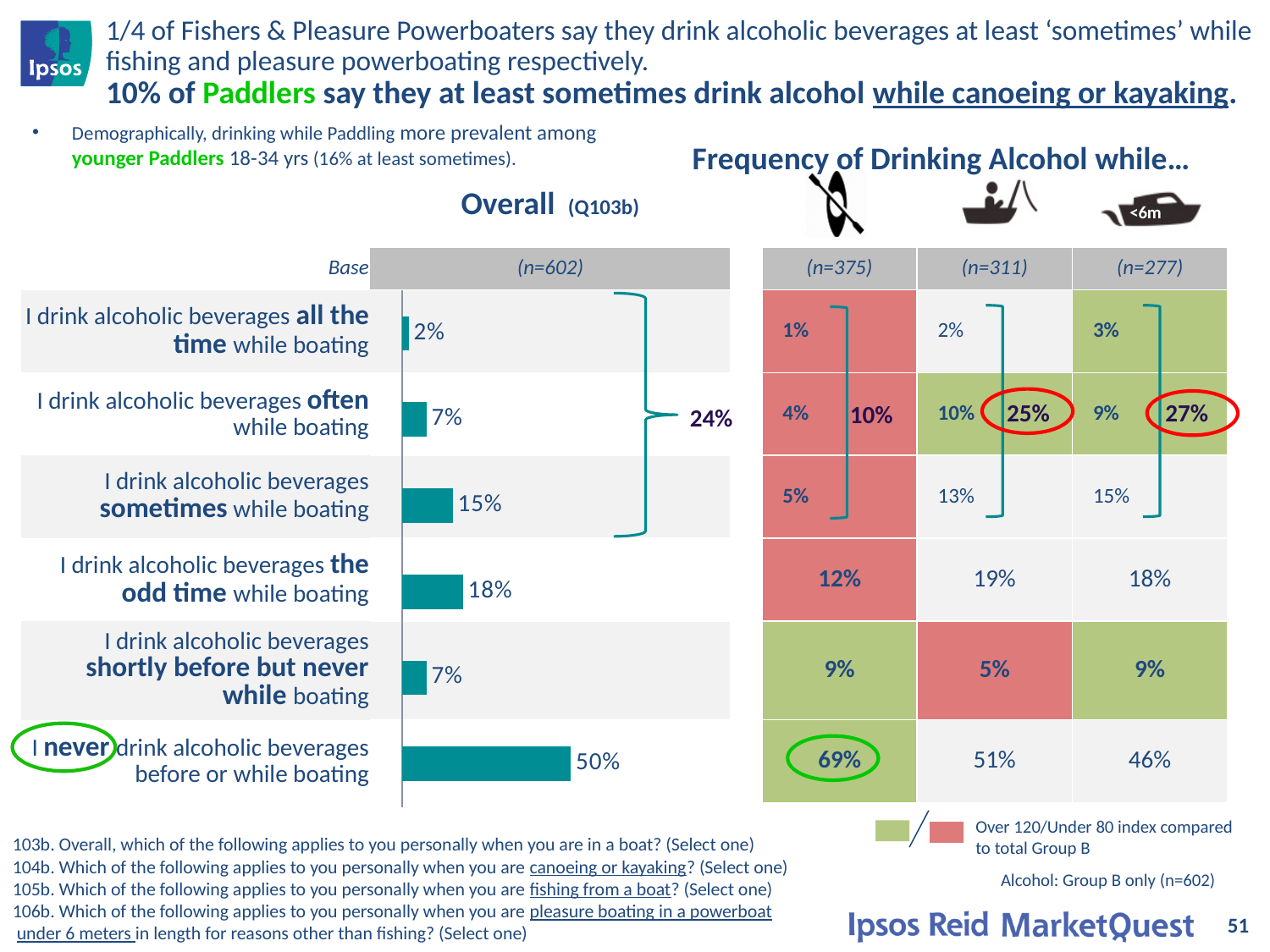
In the Overall (Q103b) bar chart, what combined percentage is shown by the bracket grouping 'all the time', 'often' and 'sometimes'? 24% What is the base size (n) shown for the Overall (Q103b) bar chart? n=602 How many categories are shown in the Overall (Q103b) bar chart? 6 What type of chart is the Overall (Q103b) chart? bar chart In the Overall (Q103b) bar chart, which category has the lowest value? I drink alcoholic beverages all the time while boating In the Overall (Q103b) bar chart, which category has the highest value? I never drink alcoholic beverages before or while boating In the Overall (Q103b) bar chart, what percentage of respondents say they never drink alcoholic beverages before or while boating? 50% In the Overall (Q103b) bar chart, what is the difference between the 'never' value and the 'the odd time' value? 32% In the Overall (Q103b) bar chart, what percentage say they drink alcoholic beverages sometimes while boating? 15% In the Overall (Q103b) bar chart, which is larger: the value for 'sometimes' or the value for 'often'? sometimes In the Overall (Q103b) bar chart, what percentage say they drink alcoholic beverages all the time while boating? 2% In the Overall (Q103b) bar chart, what percentage say they drink alcoholic beverages the odd time while boating? 18%